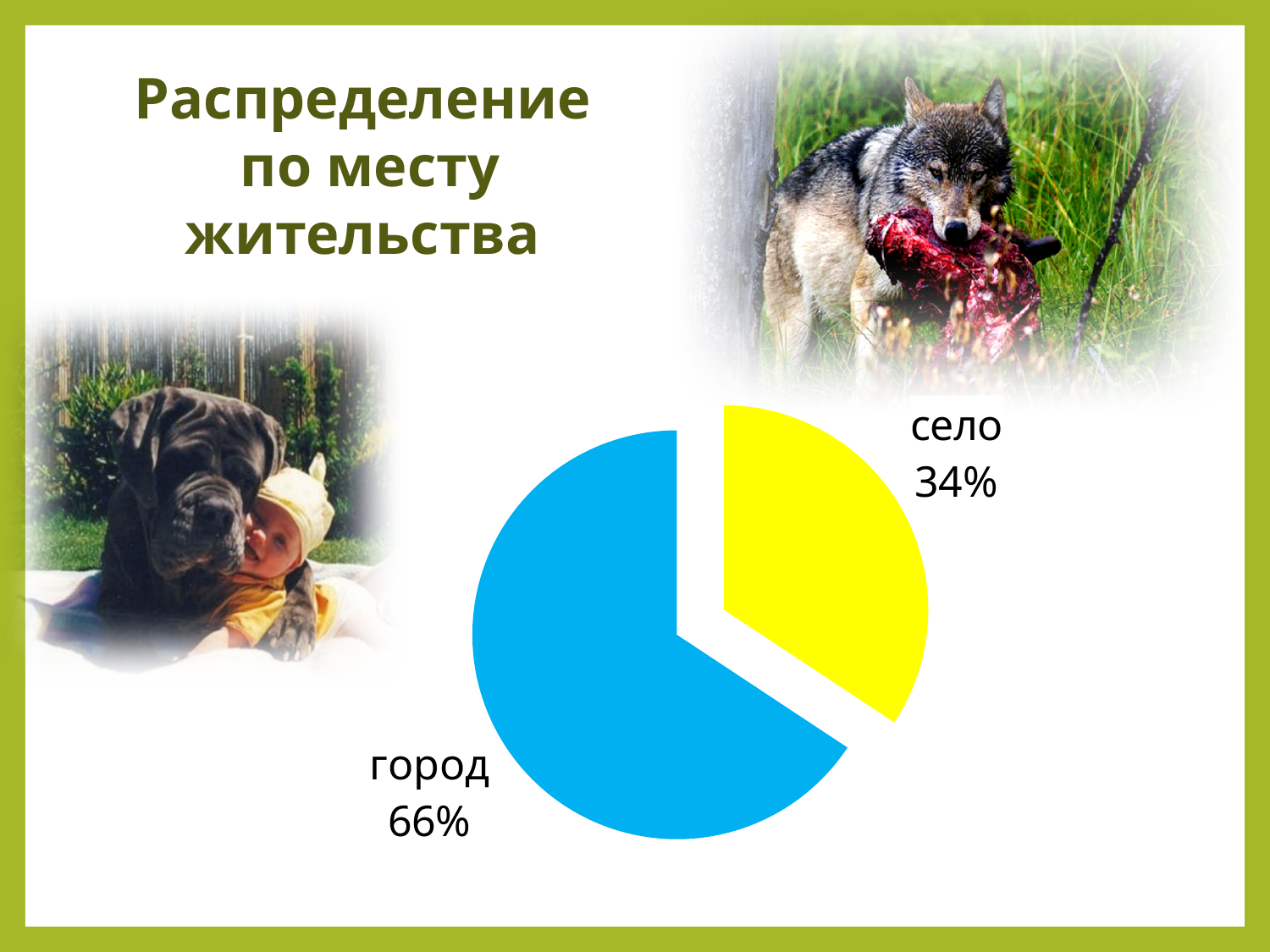
What colour is the slice for село? yellow What share of the pie does село represent? 34% Which category has the smallest slice of the pie? село Which is larger, the share for город or the share for село? город What is the title of the slide containing the chart? Распределение по месту жительства What kind of chart is shown on the slide? pie chart What is the total of the two slices shown in the pie chart? 100% Which category has the largest slice of the pie? город What share of the pie does город represent? 66% Is the share for город greater or less than 50%? greater How many slices does the pie chart have? 2 What is the difference in percentage points between город and село? 32